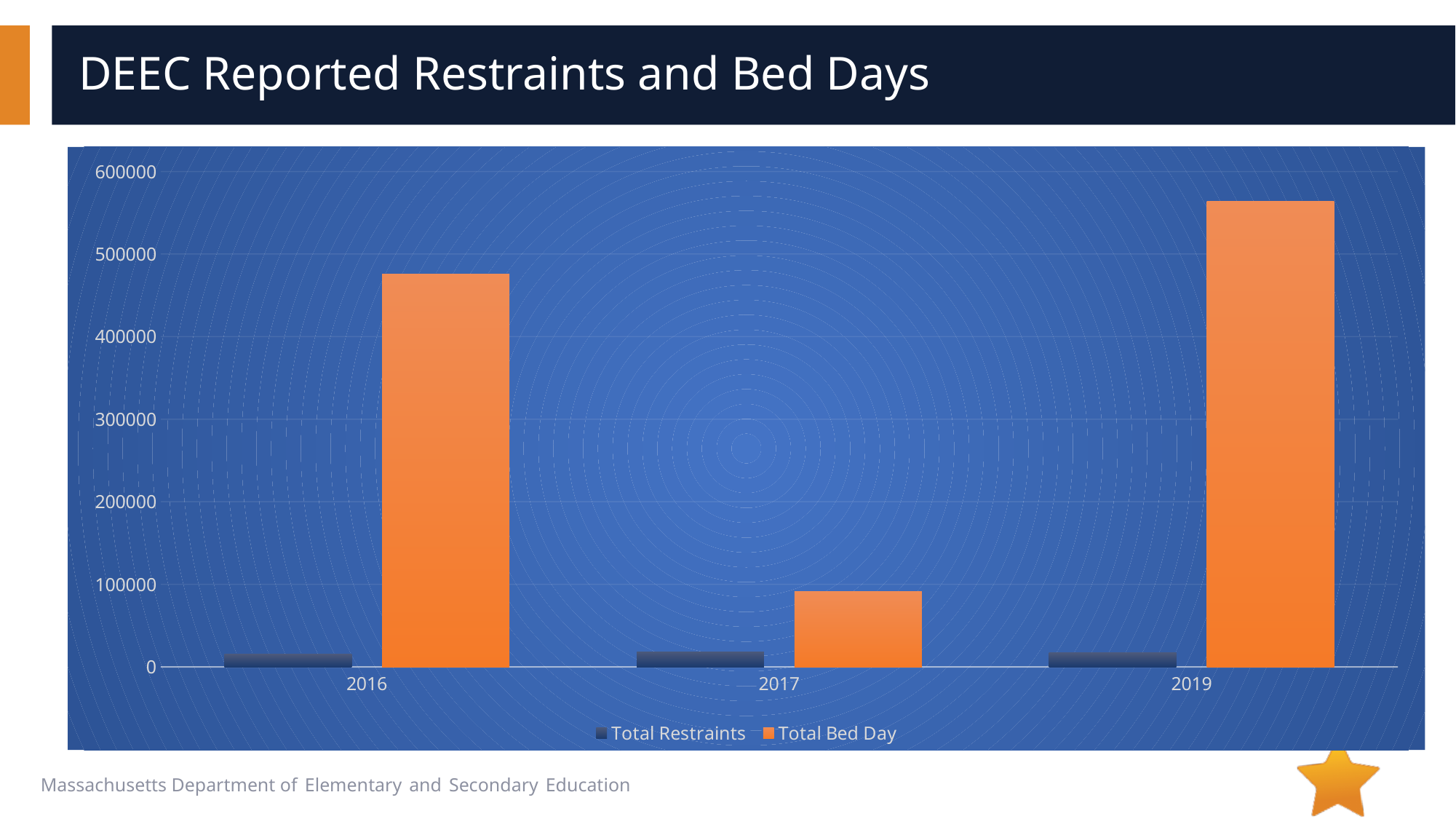
What colour are the Total Bed Day bars? orange What kind of chart is shown on the slide? bar chart Is the Total Bed Day value for 2016 greater or less than 400000? greater Which year has the lowest Total Bed Day value? 2017 Which is larger, the Total Bed Day value for 2016 or for 2019? 2019 Is the Total Bed Day value for 2017 greater or less than 100000? less Is the Total Bed Day value for 2019 greater or less than 500000? greater Which series has the larger value in 2017, Total Restraints or Total Bed Day? Total Bed Day How many series does the legend list? 2 What is the title of the chart? DEEC Reported Restraints and Bed Days How many years are shown on the x axis? 3 Which year has the highest Total Bed Day value? 2019